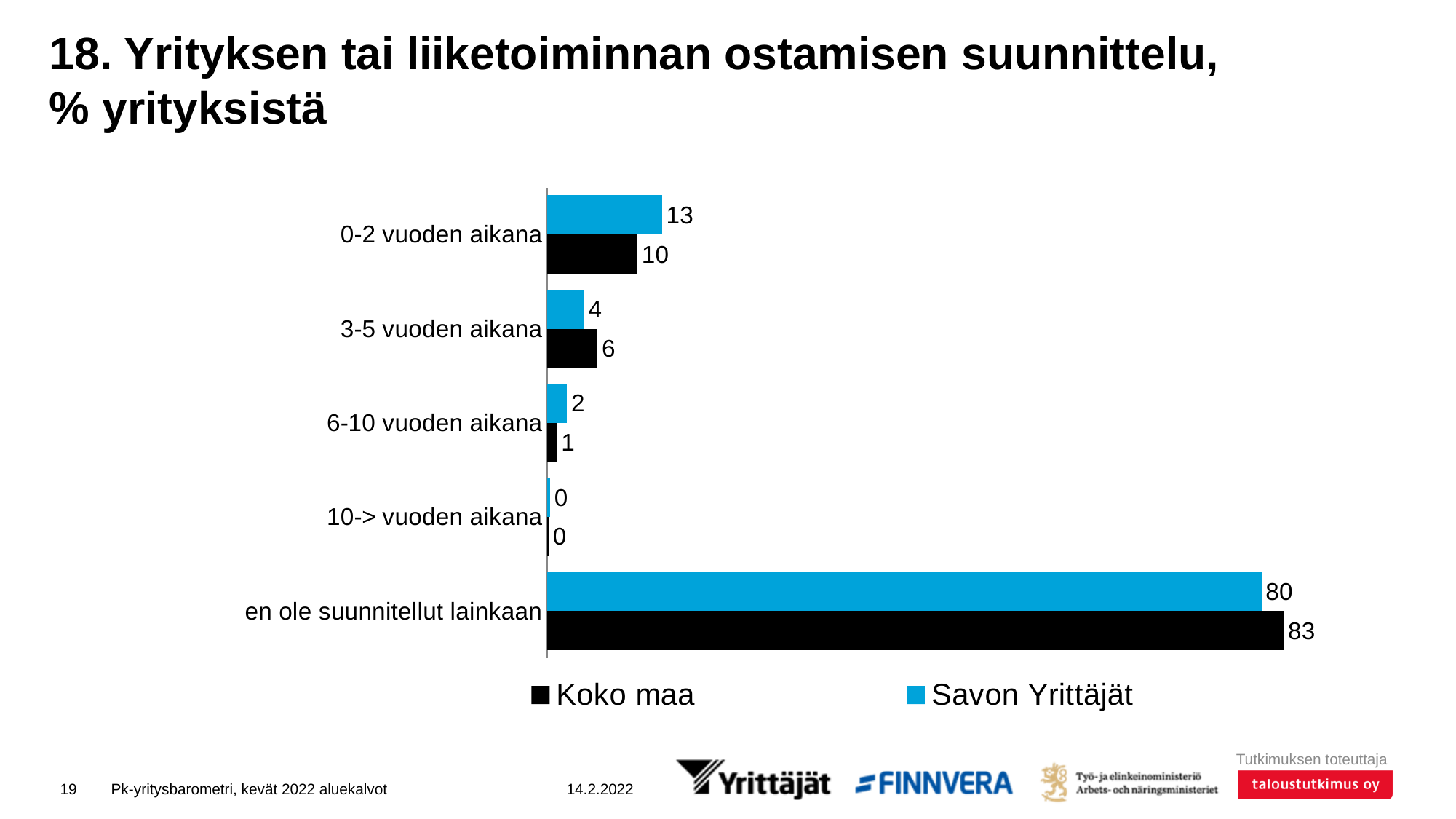
What kind of chart is shown on the slide? bar chart How many series does the legend list? 2 Which category has the highest value for Savon Yrittäjät? en ole suunnitellut lainkaan Which series has the larger value for "3-5 vuoden aikana", Koko maa or Savon Yrittäjät? Koko maa What is the value for Savon Yrittäjät in the category "0-2 vuoden aikana"? 13 Which colour represents the Savon Yrittäjät series? blue What is the value for Koko maa in the category "3-5 vuoden aikana"? 6 How many categories are shown on the chart? 5 What is the difference between the Koko maa and Savon Yrittäjät values for "0-2 vuoden aikana"? 3 Which category has the lowest value for Koko maa? 10-> vuoden aikana What is the value for Savon Yrittäjät in the category "6-10 vuoden aikana"? 2 What is the value for Koko maa in the category "en ole suunnitellut lainkaan"? 83